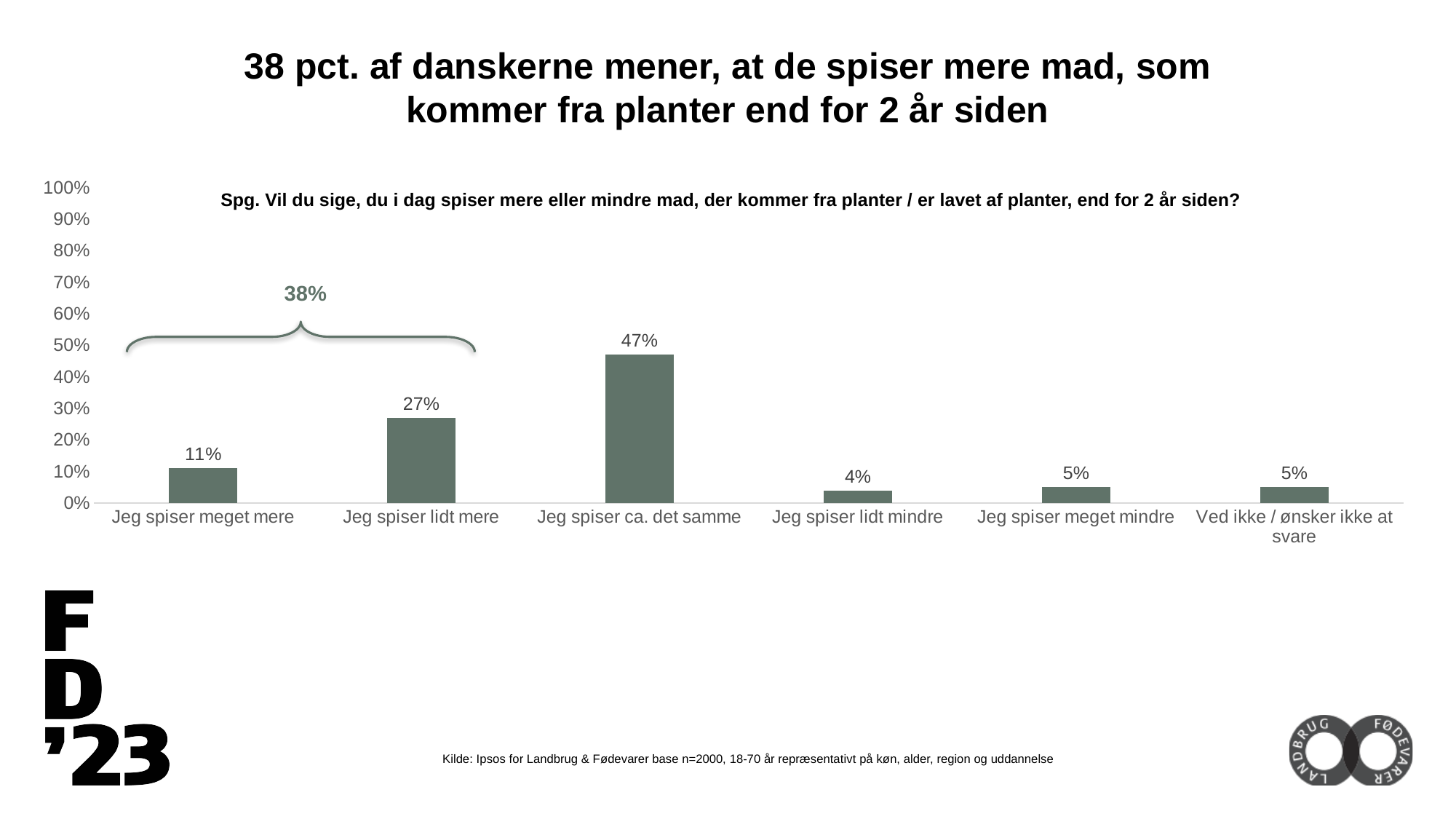
What is the value for "Jeg spiser lidt mindre"? 4% Which category has the highest value? Jeg spiser ca. det samme How many categories are shown on the x axis? 6 Which is larger, the value for "Jeg spiser meget mere" or the value for "Jeg spiser lidt mere"? Jeg spiser lidt mere What combined percentage does the bracket above the first two bars indicate? 38% What is the value for "Jeg spiser meget mere"? 11% Which category has the lowest value? Jeg spiser lidt mindre What kind of chart is shown on the slide? bar chart What percentage of respondents answered "Jeg spiser ca. det samme"? 47% What is the value for "Jeg spiser lidt mere"? 27% Is the value for "Jeg spiser ca. det samme" greater or less than 40%? greater What is the difference between "Jeg spiser ca. det samme" and "Jeg spiser lidt mere"? 20%